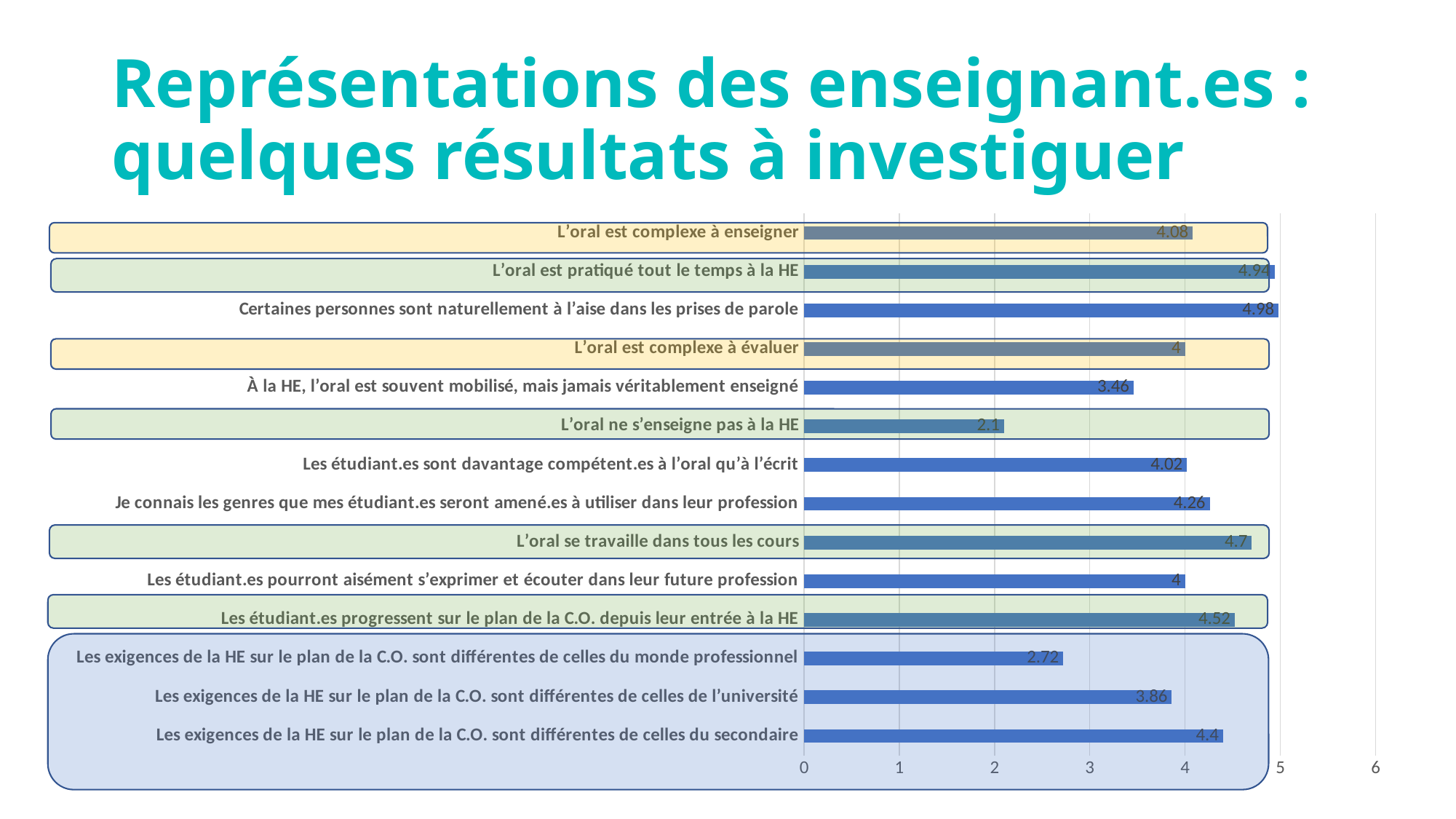
What is the highest tick value shown on the horizontal axis? 6 Which statement has the lowest value? L'oral ne s'enseigne pas à la HE What kind of chart is shown on the slide? bar chart What is the value for "L'oral se travaille dans tous les cours"? 4.7 Is the value for "À la HE, l'oral est souvent mobilisé, mais jamais véritablement enseigné" greater or less than 4? less Which statement has the highest value? Certaines personnes sont naturellement à l'aise dans les prises de parole How many statements (bars) are shown in the chart? 14 What is the value for "L'oral est complexe à enseigner"? 4.08 What is the value for "Les exigences de la HE sur le plan de la C.O. sont différentes de celles de l'université"? 3.86 What is the value for "L'oral ne s'enseigne pas à la HE"? 2.1 What is the difference between the values for "Les exigences de la HE sur le plan de la C.O. sont différentes de celles du secondaire" and "Les exigences de la HE sur le plan de la C.O. sont différentes de celles du monde professionnel"? 1.68 Which is larger: the value for "L'oral est pratiqué tout le temps à la HE" or the value for "L'oral est complexe à évaluer"? L'oral est pratiqué tout le temps à la HE